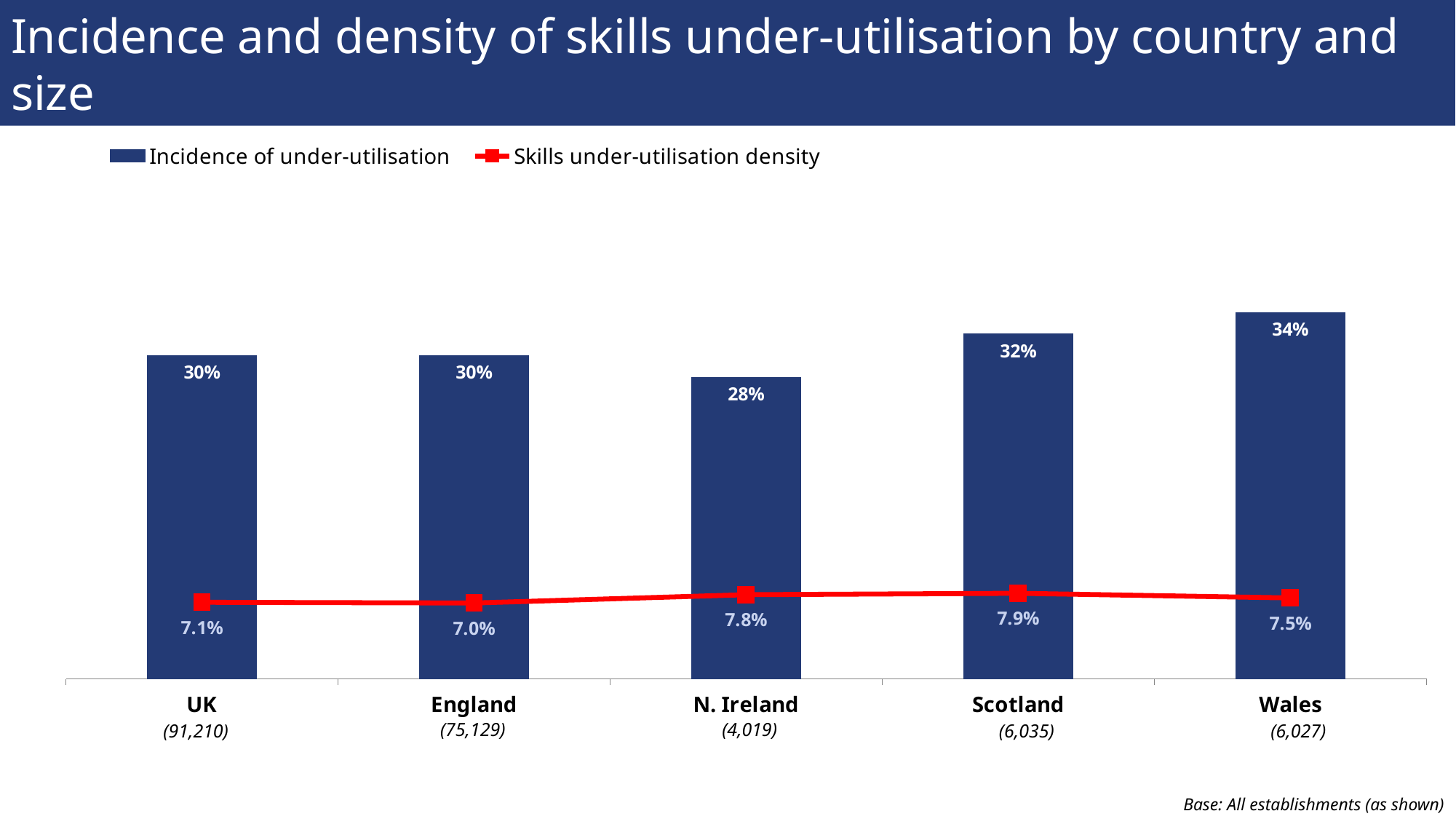
What is the incidence of under-utilisation for Scotland? 32% What is the base (number of establishments) shown for the UK? 91,210 What is the incidence of under-utilisation for Wales? 34% What is the skills under-utilisation density for N. Ireland? 7.8% How many countries are shown on the chart? 5 Which country has the lowest incidence of under-utilisation? N. Ireland What is the difference in incidence of under-utilisation between Wales and N. Ireland? 6 percentage points What is the skills under-utilisation density for England? 7.0% Which country has the highest skills under-utilisation density? Scotland Is the incidence of under-utilisation higher for Scotland or for England? Scotland Which country has the highest incidence of under-utilisation? Wales How many series does the legend list? 2